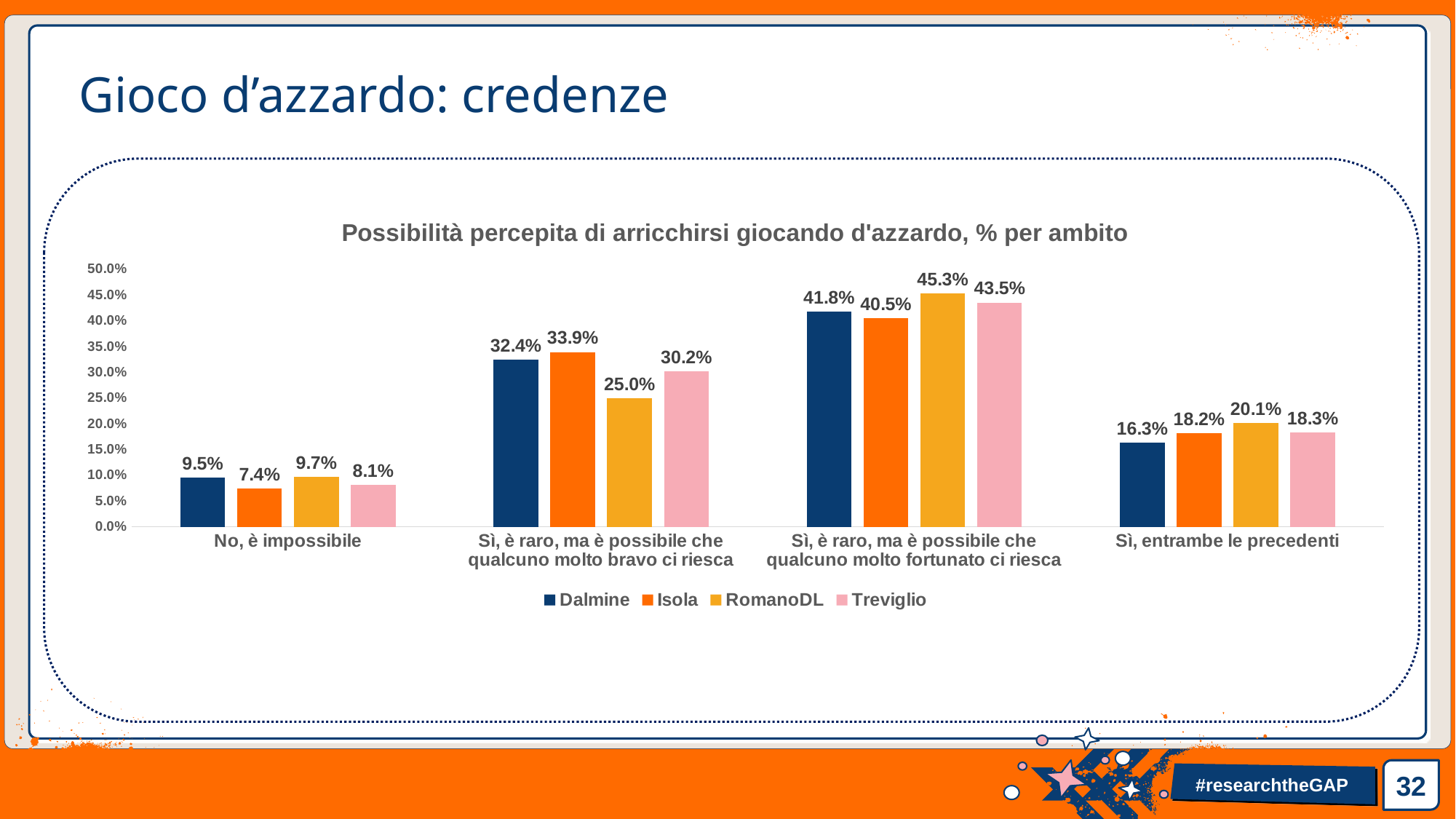
What is the value for Treviglio in the 'Sì, entrambe le precedenti' category? 18.3% How many categories are shown on the x axis? 4 What kind of chart is shown on the slide? Bar chart Which series has the highest value in the 'Sì, è raro, ma è possibile che qualcuno molto bravo ci riesca' category? Isola What is the difference between the RomanoDL and Isola values in the 'Sì, è raro, ma è possibile che qualcuno molto fortunato ci riesca' category? 4.8% Is the value for Treviglio in the 'Sì, è raro, ma è possibile che qualcuno molto bravo ci riesca' category greater or less than 35.0%? less How many series does the legend list? 4 What is the value for Dalmine in the 'No, è impossibile' category? 9.5% What is the title of the chart? Possibilità percepita di arricchirsi giocando d'azzardo, % per ambito What is the value for RomanoDL in the 'Sì, è raro, ma è possibile che qualcuno molto fortunato ci riesca' category? 45.3% Which series has the lowest value in the 'No, è impossibile' category? Isola Which is larger in the 'Sì, entrambe le precedenti' category: Dalmine or RomanoDL? RomanoDL